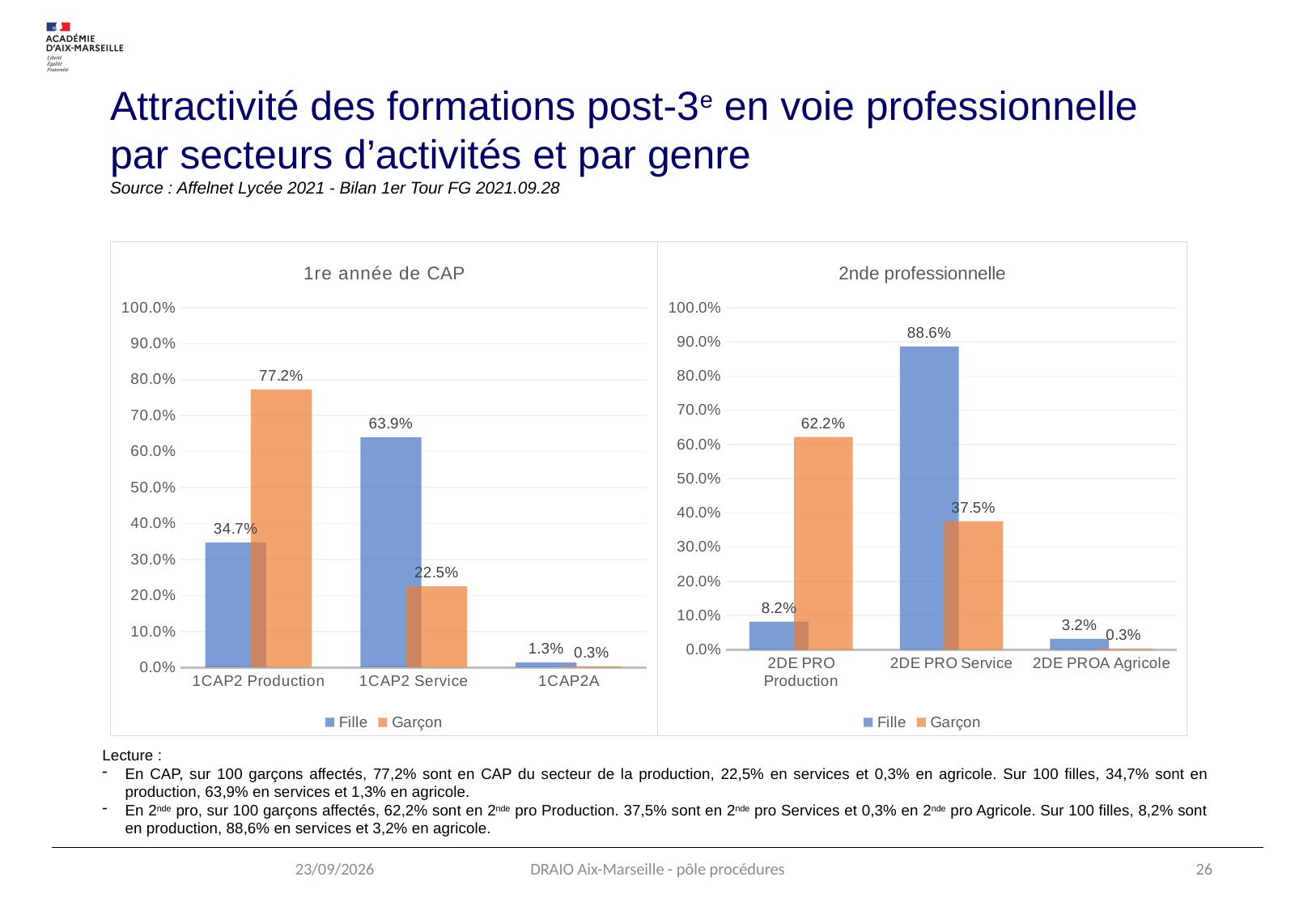
How many series does the legend of the '2nde professionnelle' chart list? 2 In the '2nde professionnelle' chart, what is the value for Fille in 2DE PRO Service? 88.6% In the '2nde professionnelle' chart, which category has the lowest value for Garçon? 2DE PROA Agricole In the '2nde professionnelle' chart, what is the value for Garçon in 2DE PRO Production? 62.2% In the '1re année de CAP' chart, what is the value for Garçon in 1CAP2 Production? 77.2% In the '1re année de CAP' chart, what is the difference between the Garçon and Fille values for 1CAP2 Production? 42.5% In the '1re année de CAP' chart, what is the value for Fille in 1CAP2 Service? 63.9% What kind of chart is the '1re année de CAP' chart? Bar chart In the '2nde professionnelle' chart, which is larger for 2DE PRO Service: Fille or Garçon? Fille How many categories are shown on the x axis of the '1re année de CAP' chart? 3 In the '1re année de CAP' chart, which category has the highest value for Fille? 1CAP2 Service In the '2nde professionnelle' chart, is the value for Garçon in 2DE PRO Service greater or less than 40.0%? less